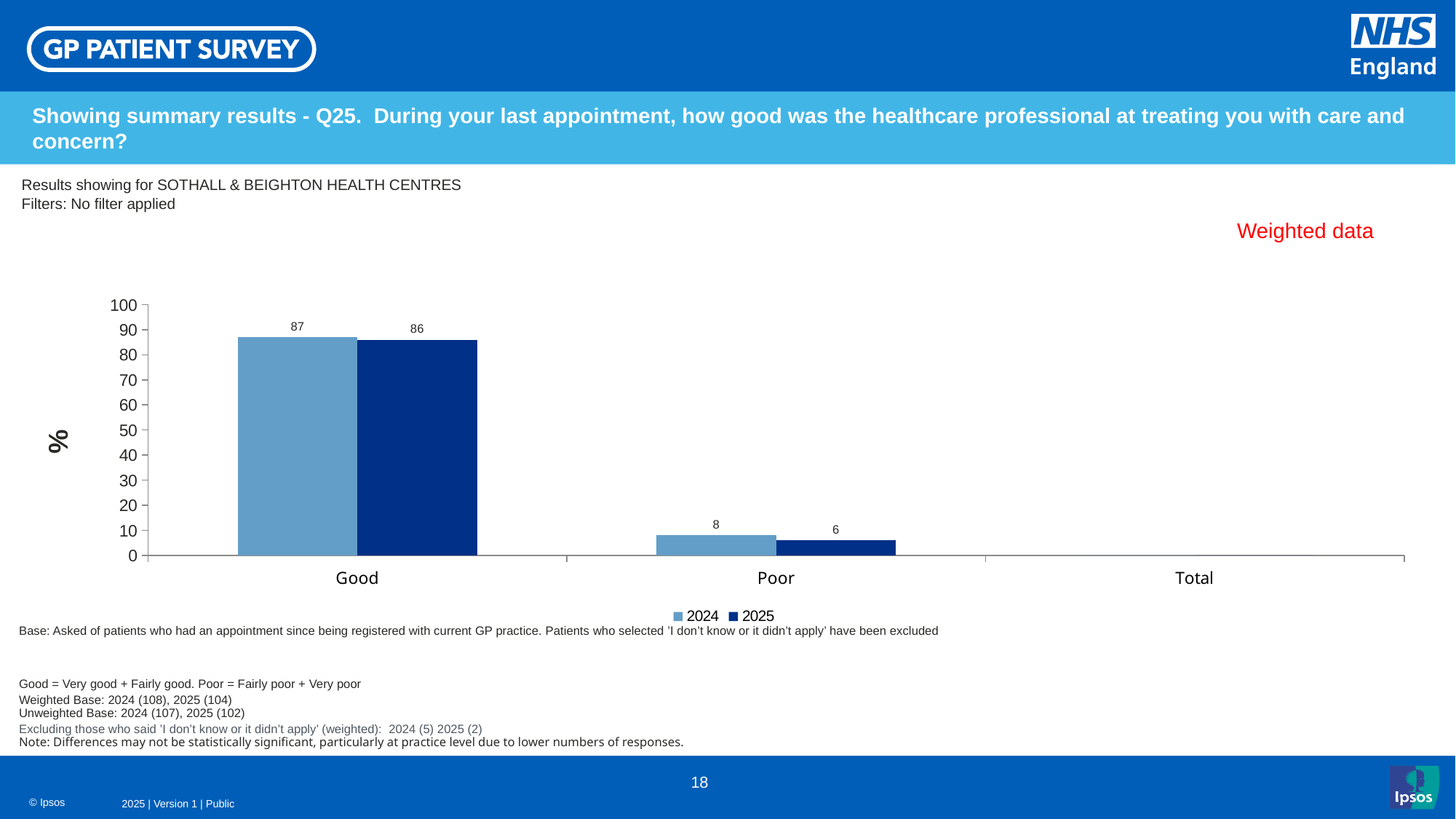
What is the value for Poor in 2025? 6 What is the value for Good in 2024? 87 Which is larger, the 2024 value for Good or the 2025 value for Good? 2024 What label is shown on the y axis of the chart? % What kind of chart is shown on the slide? Bar chart How many series does the legend list? 2 What is the difference between the Good and Poor values in 2024? 79 What is the value for Good in 2025? 86 Is the value for Poor in 2024 greater or less than 10? less What is the value for Poor in 2024? 8 Which category has the highest value in the 2025 series? Good What is the difference between the 2024 and 2025 values for Poor? 2